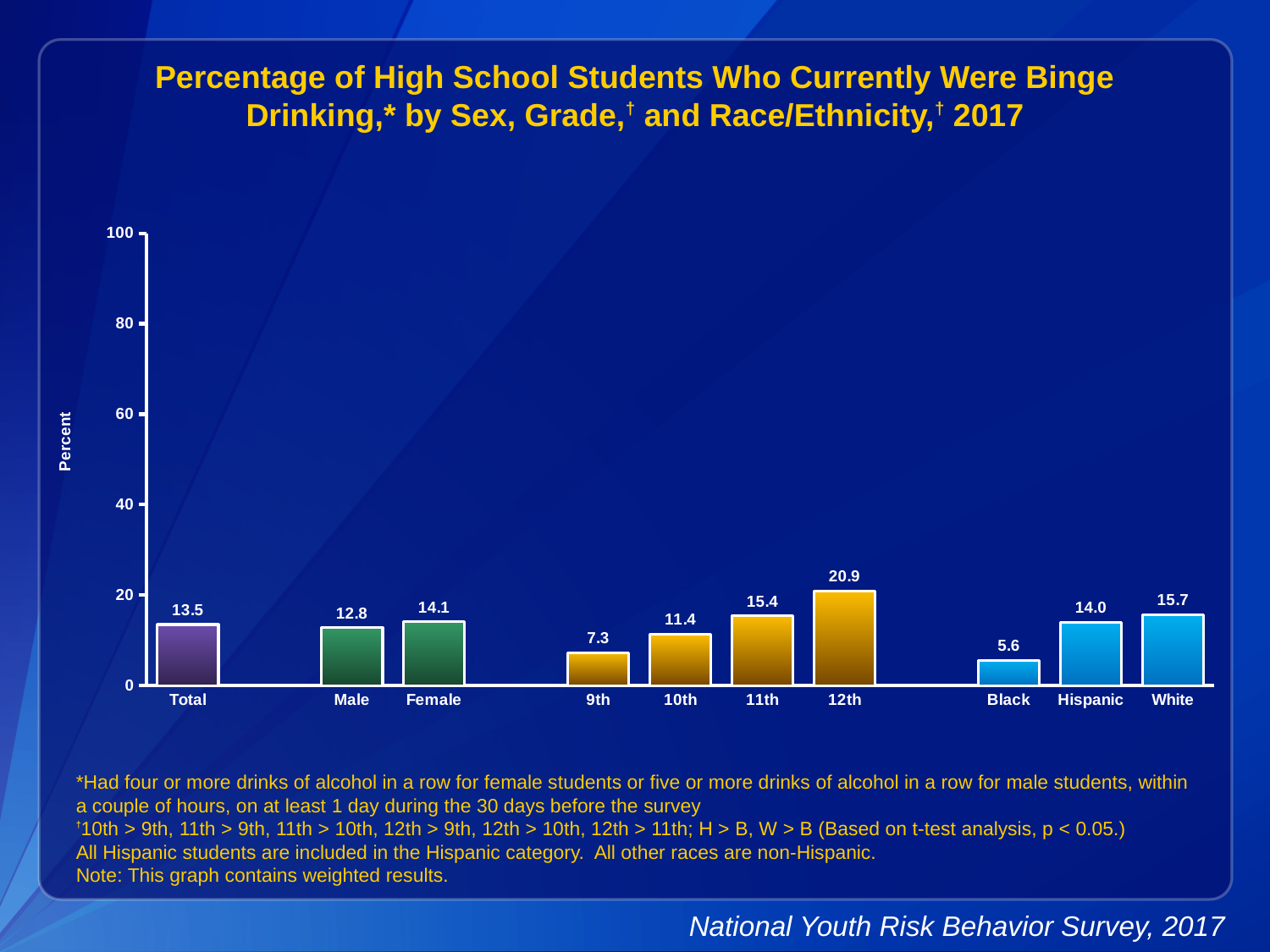
Which is larger, the value for White or the value for Hispanic? White Do the values rise or fall from 9th grade to 12th grade? rise What is the value for Total? 13.5 Is the value for 11th grade greater or less than 20? less What kind of chart is this? bar chart How many categories are shown on the x axis? 10 Which category has the lowest value? Black What is the value for 12th grade? 20.9 What is the difference between the values for Female and Male? 1.3 What is the value for Black students? 5.6 Which category has the highest value? 12th What is the difference between the values for 12th and 9th grade? 13.6